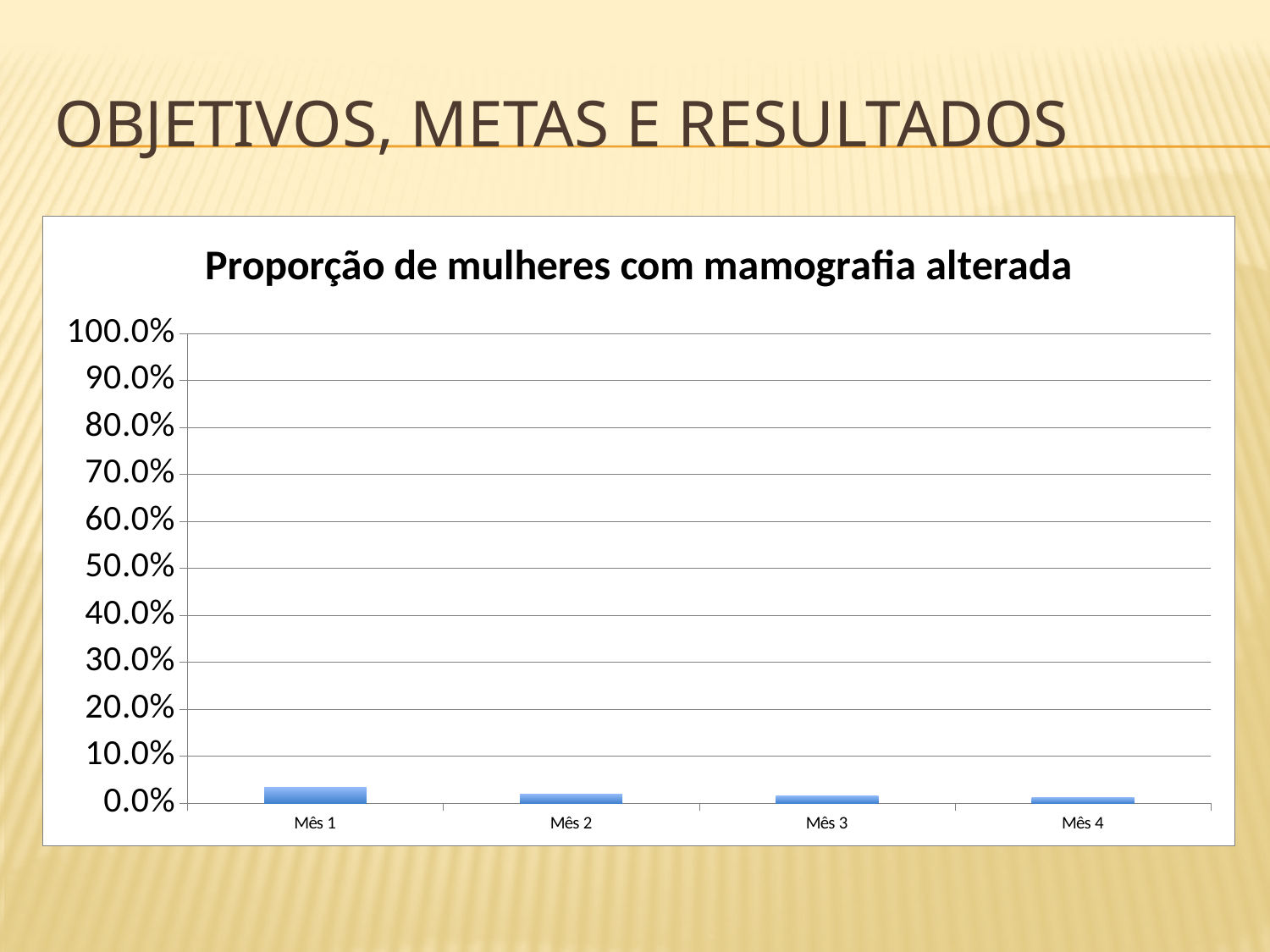
Is the value for Mês 4 greater or less than 10.0%? less What is the title of the chart? Proporção de mulheres com mamografia alterada What is the highest value shown on the y axis of the chart? 100.0% What type of chart is shown on the slide? bar chart Do the values rise or fall from Mês 1 to Mês 4? fall Is the value for Mês 2 greater or less than 20.0%? less Is the value for Mês 1 greater or less than 10.0%? less How many categories are shown on the x axis of the chart? 4 Which is larger, the value for Mês 1 or the value for Mês 4? Mês 1 Which is larger, the value for Mês 1 or the value for Mês 3? Mês 1 Which category has the highest value in the chart? Mês 1